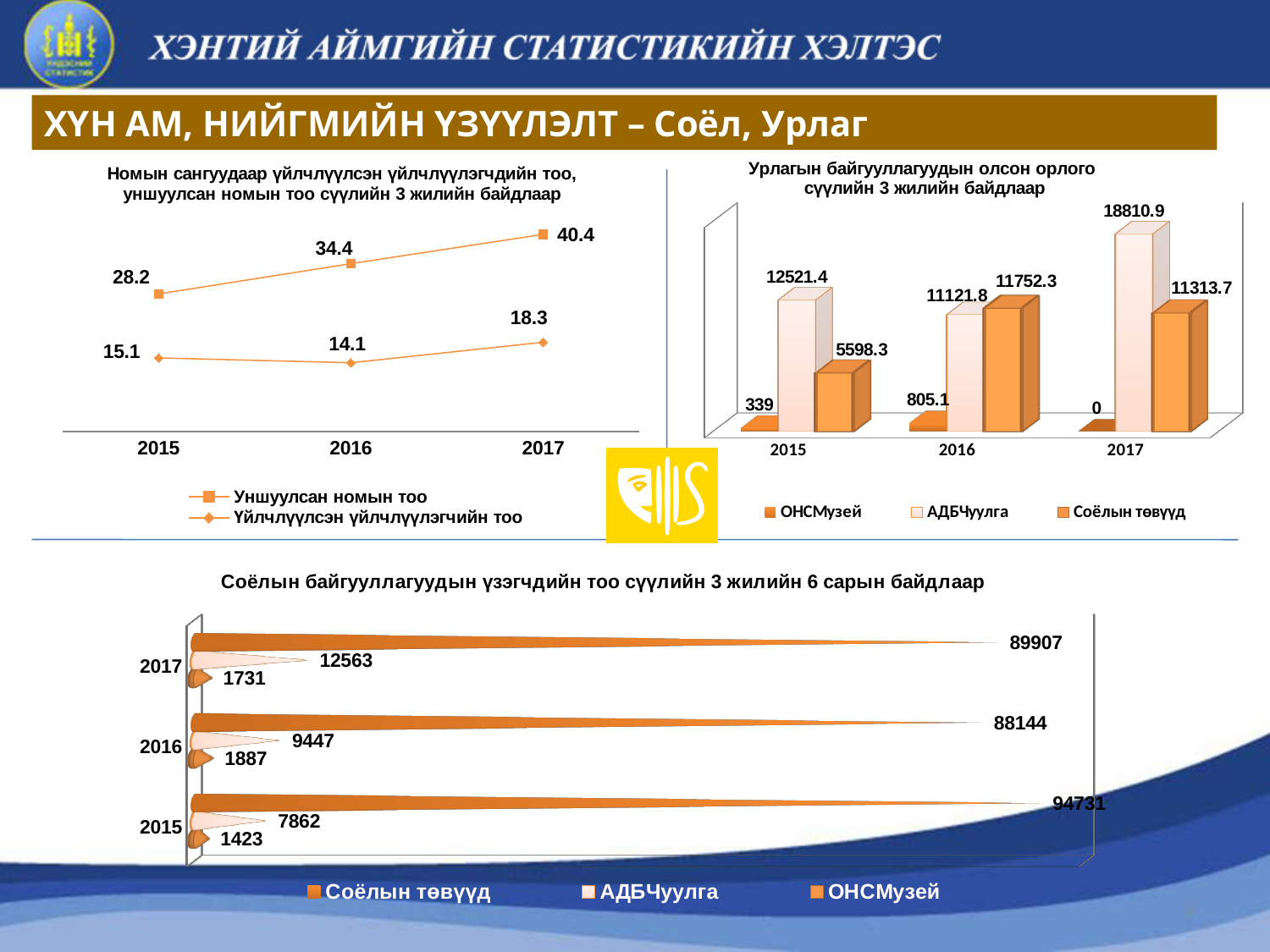
In the bottom chart (Соёлын байгууллагуудын үзэгчдийн тоо), what is the largest value shown for 2015? 94731 In the top-right chart (Урлагын байгууллагуудын олсон орлого), what is the value of ОНСМузей for 2016? 805.1 In the bottom chart (Соёлын байгууллагуудын үзэгчдийн тоо), what is the value of АДБЧуулга for 2016? 9447 In the top-right chart (Урлагын байгууллагуудын олсон орлого), which is larger in 2015: АДБЧуулга or Соёлын төвүүд? АДБЧуулга In the top-right chart (Урлагын байгууллагуудын олсон орлого), what is the value of АДБЧуулга for 2017? 18810.9 In the top-right chart (Урлагын байгууллагуудын олсон орлого), which year has the highest value for Соёлын төвүүд? 2016 What type of chart is the top-left chart? line chart In the top-left chart, what is the difference between Уншуулсан номын тоо and Үйлчлүүлсэн үйлчлүүлэгчийн тоо in 2015? 13.1 In the top-left chart, what is the value of Үйлчлүүлсэн үйлчлүүлэгчийн тоо for 2016? 14.1 How many series does the legend of the top-right chart list? 3 In the top-left chart, what is the value of Уншуулсан номын тоо for 2017? 40.4 In the top-left chart, does Уншуулсан номын тоо rise or fall from 2015 to 2017? rise